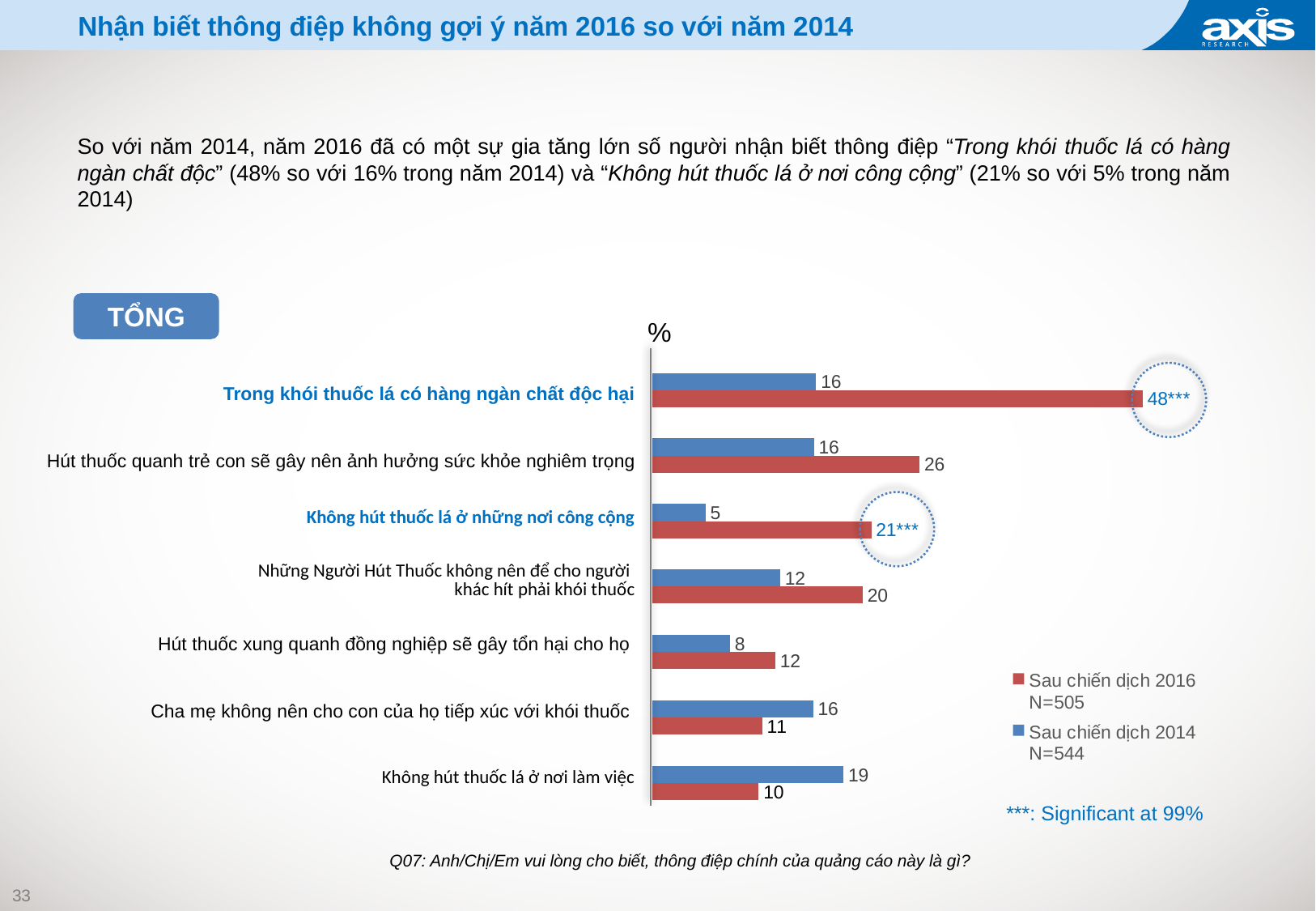
What is the value for "Trong khói thuốc lá có hàng ngàn chất độc hại" in the "Sau chiến dịch 2016" series? 48*** What is the value for "Không hút thuốc lá ở nơi làm việc" in the "Sau chiến dịch 2016" series? 10 Which colour represents the "Sau chiến dịch 2014" series? blue What is the value for "Không hút thuốc lá ở những nơi công cộng" in the "Sau chiến dịch 2014" series? 5 Which category has the highest value in the "Sau chiến dịch 2016" series? Trong khói thuốc lá có hàng ngàn chất độc hại What is the difference between the 2016 and 2014 values for "Hút thuốc quanh trẻ con sẽ gây nên ảnh hưởng sức khỏe nghiêm trọng"? 10 What is the sample size (N) shown in the legend for "Sau chiến dịch 2016"? N=505 Which category has the lowest value in the "Sau chiến dịch 2014" series? Không hút thuốc lá ở những nơi công cộng How many series does the legend list? 2 What kind of chart is shown on the slide? bar chart For "Cha mẹ không nên cho con của họ tiếp xúc với khói thuốc", which series has the larger value, "Sau chiến dịch 2016" or "Sau chiến dịch 2014"? Sau chiến dịch 2014 How many categories (messages) are plotted in the chart? 7